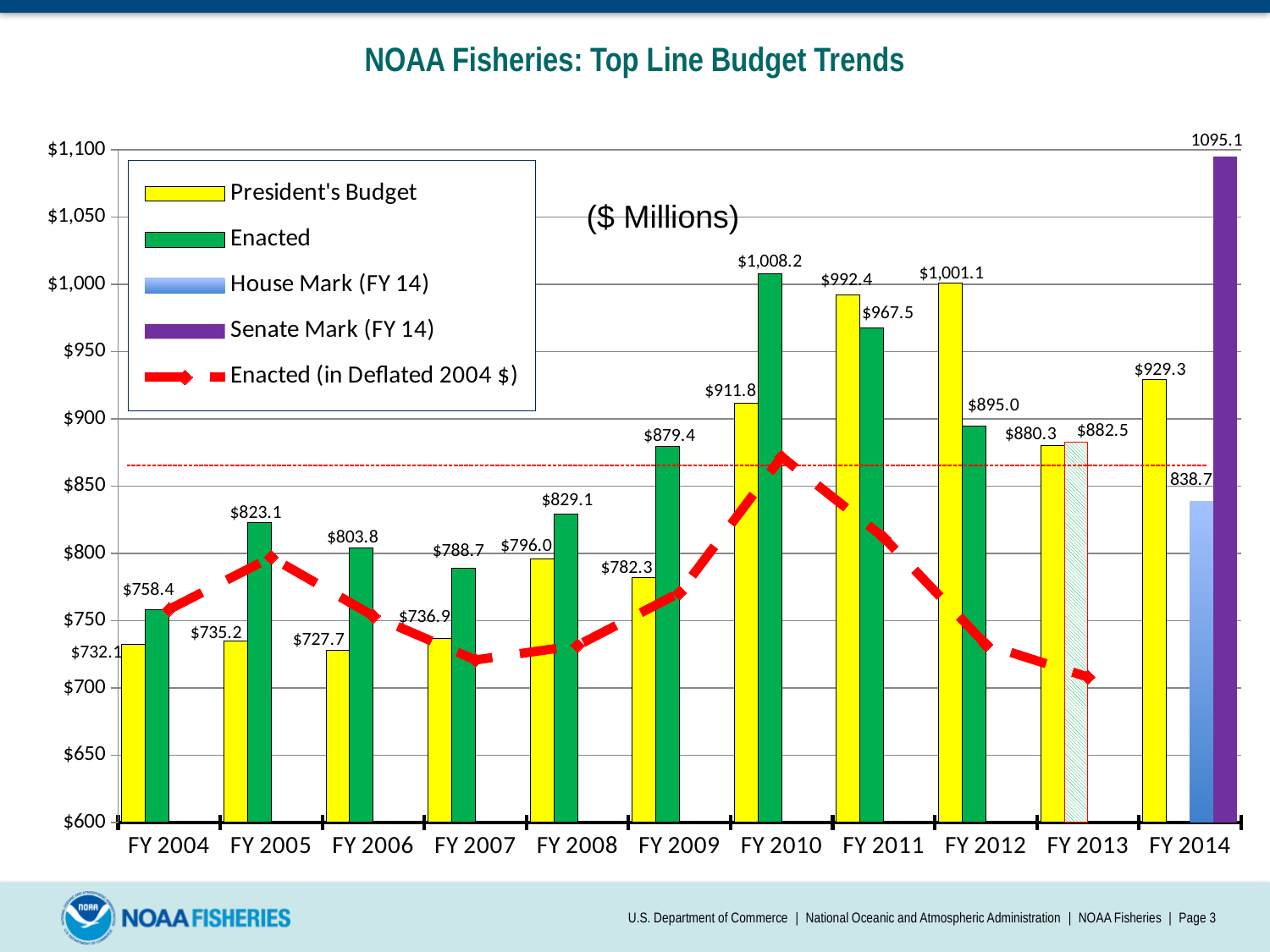
Do the Enacted values rise or fall from FY 2004 to FY 2010? Rise In which fiscal year is the President's Budget value lowest? FY 2006 What is the House Mark (FY 14) value shown for FY 2014? 838.7 What is the President's Budget value for FY 2012? $1,001.1 How many fiscal years are shown on the x axis? 11 In which fiscal year is the Enacted value highest? FY 2010 How many series does the legend list? 5 What is the Senate Mark (FY 14) value shown for FY 2014? 1095.1 What is the difference between the President's Budget and the Enacted value in FY 2011? $24.9 What kind of chart is used to show the President's Budget and Enacted series? Bar chart In FY 2012, which is larger: the President's Budget or the Enacted value? President's Budget What is the Enacted value for FY 2010? $1,008.2